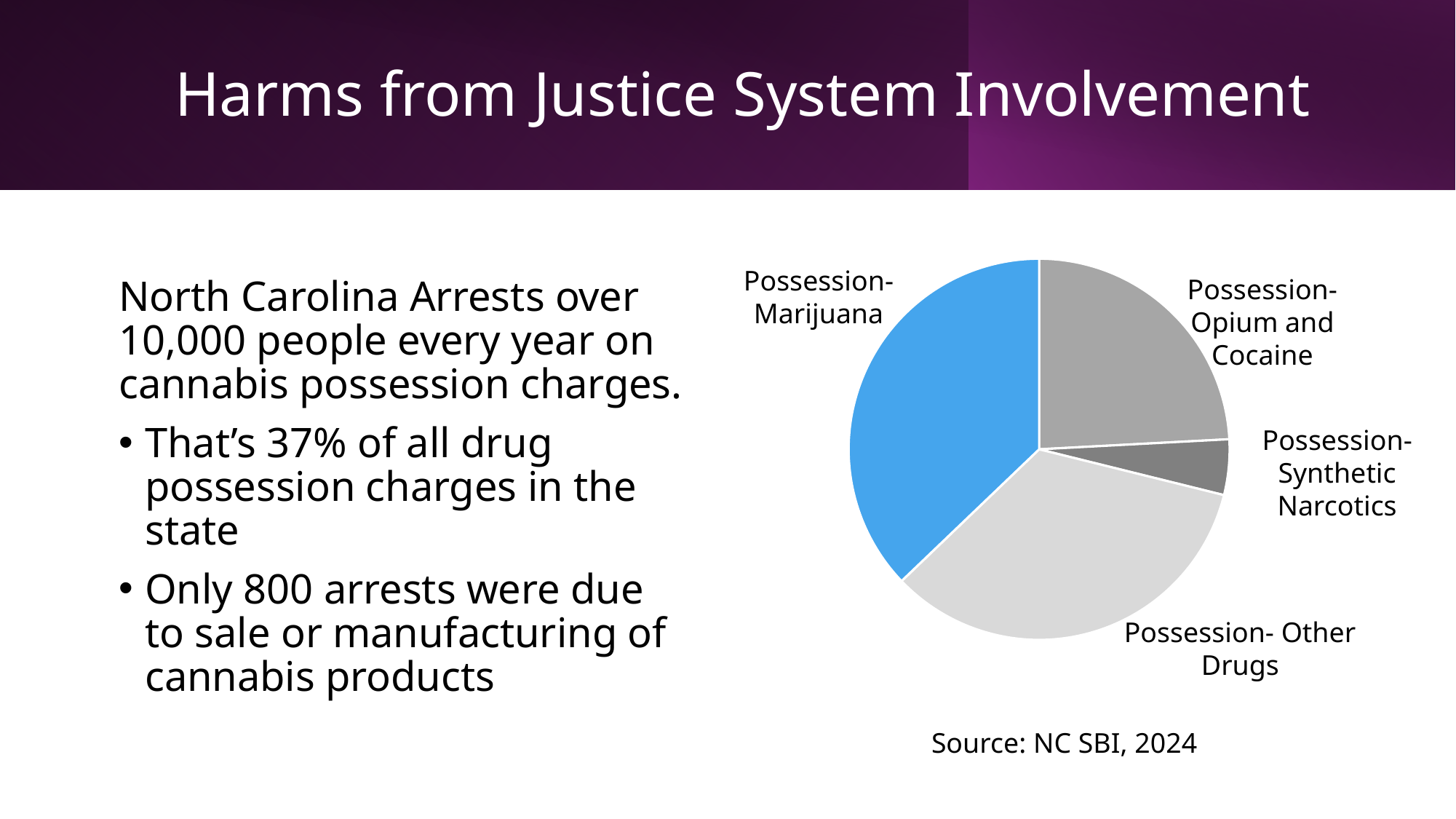
Which slice is larger: Possession- Other Drugs or Possession- Opium and Cocaine? Possession- Other Drugs Which slice is larger: Possession- Other Drugs or Possession- Synthetic Narcotics? Possession- Other Drugs Which slice is larger: Possession- Marijuana or Possession- Opium and Cocaine? Possession- Marijuana What kind of chart is shown on the slide? pie chart What colour is the Possession- Marijuana slice in the pie chart? blue Which category has the smallest slice in the pie chart? Possession- Synthetic Narcotics How many slices does the pie chart have? 4 What source is cited below the pie chart? NC SBI, 2024